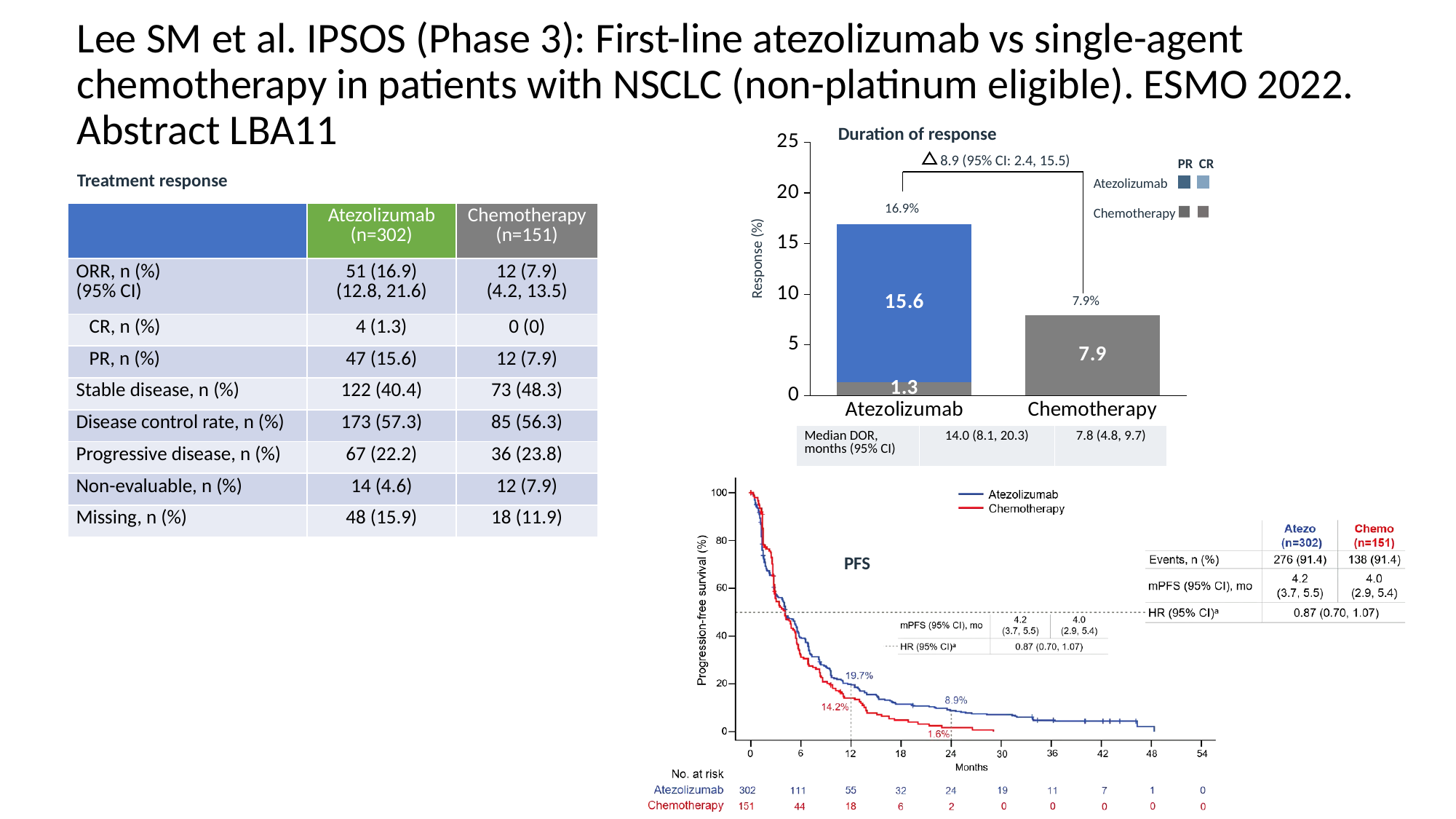
In the PFS chart, how many series does the legend list? 2 In the 'Duration of response' bar chart, what is the PR value for Atezolizumab? 15.6 In the 'Duration of response' bar chart, what is the total response percentage labelled above the Atezolizumab bar? 16.9% In the 'Duration of response' bar chart, which treatment has the higher total response rate? Atezolizumab What kind of chart is the 'Duration of response' chart? Stacked bar chart In the 'Duration of response' bar chart, what is the total response percentage labelled above the Chemotherapy bar? 7.9% In the PFS chart, what is the progression-free survival percentage for Atezolizumab at 12 months? 19.7% In the PFS chart, what is the progression-free survival percentage for Chemotherapy at 24 months? 1.6% In the 'Duration of response' bar chart, what is the difference between the Atezolizumab and Chemotherapy total response rates? 8.9 In the PFS chart, how many Chemotherapy patients were at risk at 12 months? 18 In the 'Duration of response' bar chart, what is the CR value for Atezolizumab? 1.3 In the 'Duration of response' bar chart, is the Chemotherapy bar greater or less than 10 on the Response (%) axis? less